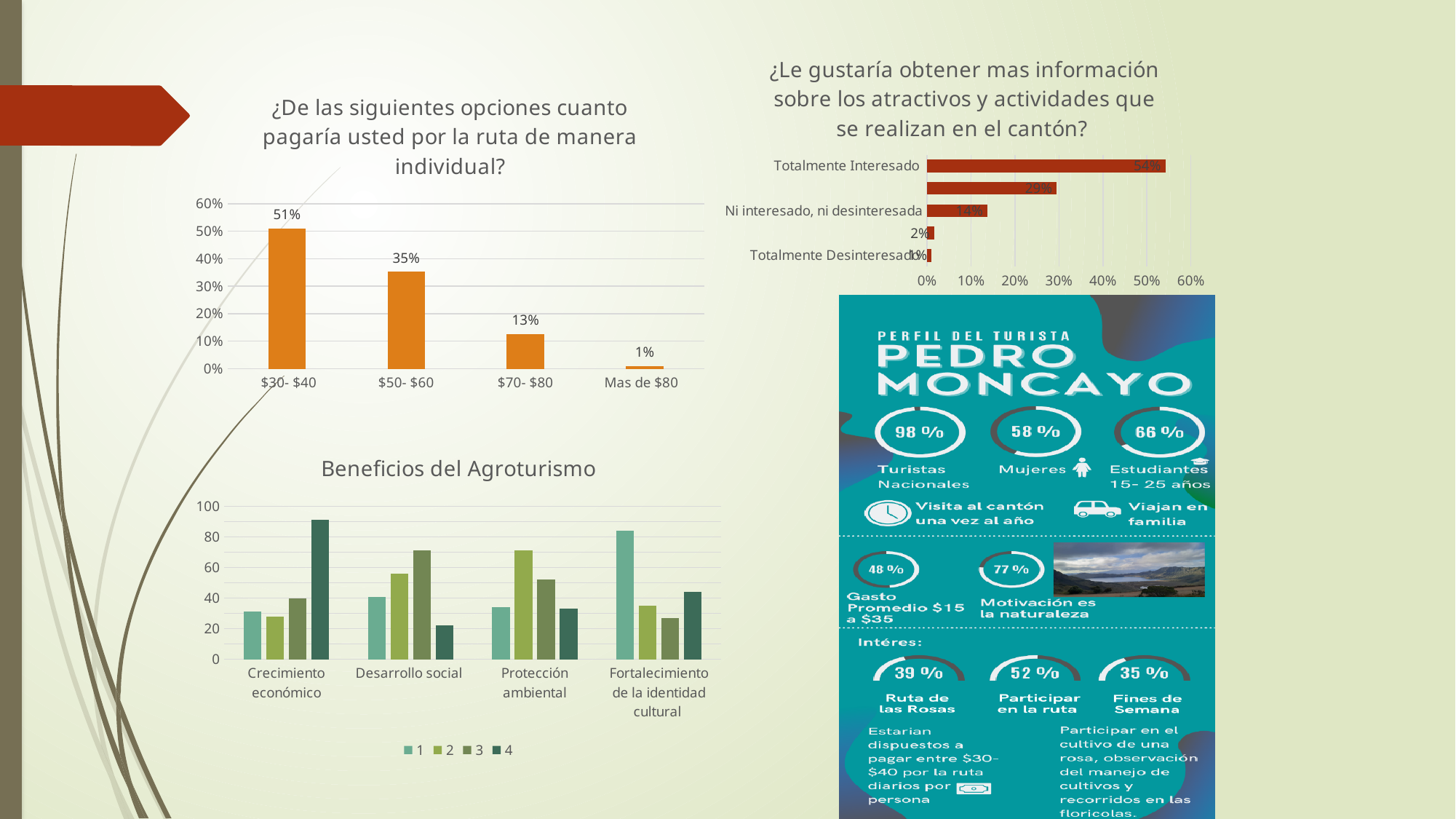
In the chart titled '¿De las siguientes opciones cuanto pagaría usted por la ruta de manera individual?', do the values rise or fall from left to right along the x axis? fall In the chart titled 'Beneficios del Agroturismo', is the value of series 4 for Crecimiento económico greater or less than 80? greater In the chart titled '¿Le gustaría obtener mas información sobre los atractivos y actividades que se realizan en el cantón?', how many bars are plotted? 5 In the chart titled '¿De las siguientes opciones cuanto pagaría usted por la ruta de manera individual?', what is the difference between the $30- $40 and $50- $60 values? 16% In the chart titled '¿Le gustaría obtener mas información sobre los atractivos y actividades que se realizan en el cantón?', what kind of chart is used? bar chart In the chart titled 'Beneficios del Agroturismo', which is larger for Desarrollo social: series 1 or series 3? series 3 In the chart titled '¿Le gustaría obtener mas información sobre los atractivos y actividades que se realizan en el cantón?', what percentage is shown for Totalmente Interesado? 54% In the chart titled '¿De las siguientes opciones cuanto pagaría usted por la ruta de manera individual?', which option has the lowest value? Mas de $80 In the chart titled '¿De las siguientes opciones cuanto pagaría usted por la ruta de manera individual?', what percentage is shown for $70- $80? 13% In the chart titled '¿De las siguientes opciones cuanto pagaría usted por la ruta de manera individual?', what percentage is shown for $30- $40? 51% In the chart titled '¿Le gustaría obtener mas información sobre los atractivos y actividades que se realizan en el cantón?', what percentage is shown for Ni interesado, ni desinteresada? 14% In the chart titled 'Beneficios del Agroturismo', how many series does the legend list? 4